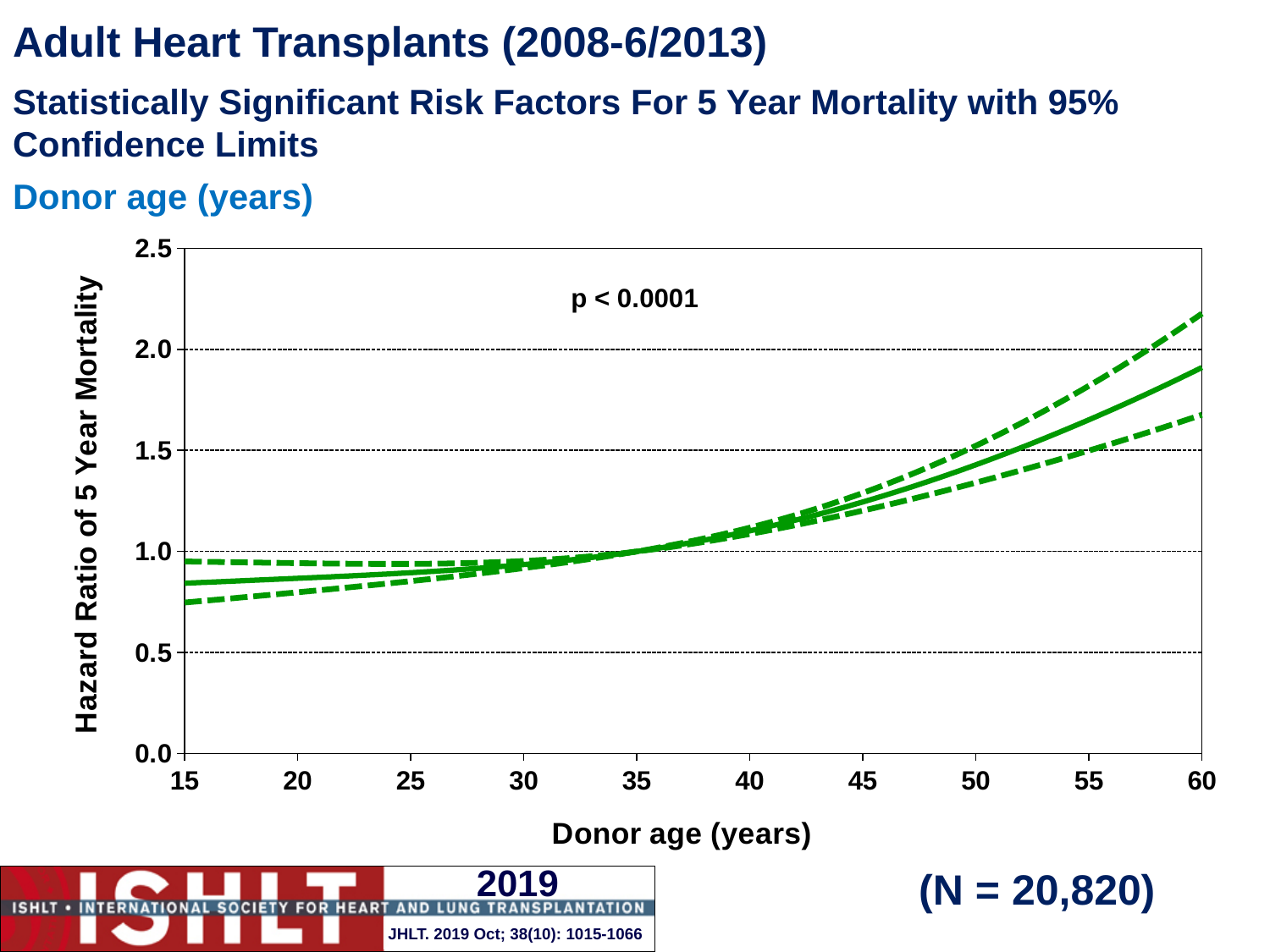
Is the hazard ratio (solid line) at donor age 60 greater or less than 1.5? greater Is the hazard ratio (solid line) at donor age 45 greater or less than 1.0? greater What p-value is printed on the chart? p < 0.0001 Is the lower confidence limit (lower dashed line) at donor age 15 greater or less than 0.5? greater Does the hazard ratio of 5 year mortality rise or fall as donor age increases from 15 to 60 years? rise What kind of chart is shown on the slide? line chart How many lines are plotted on the chart? 3 What is the label of the y axis? Hazard Ratio of 5 Year Mortality